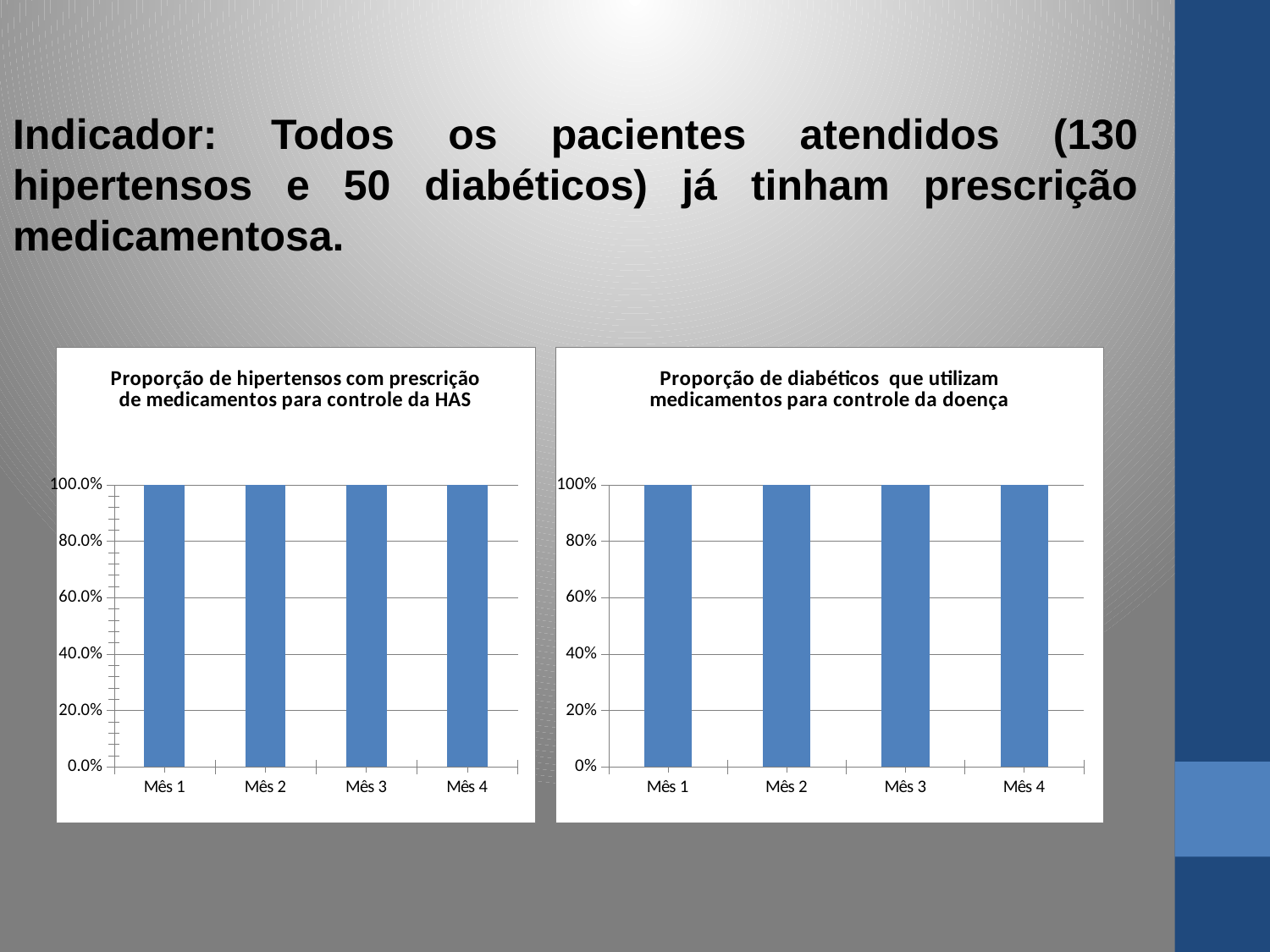
What is the title of the left chart on the slide? Proporção de hipertensos com prescrição de medicamentos para controle da HAS In the left chart, 'Proporção de hipertensos com prescrição de medicamentos para controle da HAS', do the values rise, fall or stay the same from Mês 1 to Mês 4? Stay the same In the right chart, 'Proporção de diabéticos que utilizam medicamentos para controle da doença', what is the difference between the values for Mês 1 and Mês 3? 0% In the right chart, 'Proporção de diabéticos que utilizam medicamentos para controle da doença', do the values rise, fall or stay the same from Mês 1 to Mês 4? Stay the same In the right chart, 'Proporção de diabéticos que utilizam medicamentos para controle da doença', what is the value for Mês 4? 100% How many bars are plotted in the right chart, 'Proporção de diabéticos que utilizam medicamentos para controle da doença'? 4 In the left chart, 'Proporção de hipertensos com prescrição de medicamentos para controle da HAS', what is the value for Mês 1? 100.0% What kind of chart is the left chart, 'Proporção de hipertensos com prescrição de medicamentos para controle da HAS'? Bar chart In the right chart, 'Proporção de diabéticos que utilizam medicamentos para controle da doença', what is the value for Mês 2? 100% How many categories are shown on the x axis of the left chart, 'Proporção de hipertensos com prescrição de medicamentos para controle da HAS'? 4 What kind of chart is the right chart, 'Proporção de diabéticos que utilizam medicamentos para controle da doença'? Bar chart In the left chart, 'Proporção de hipertensos com prescrição de medicamentos para controle da HAS', what is the value for Mês 3? 100.0%